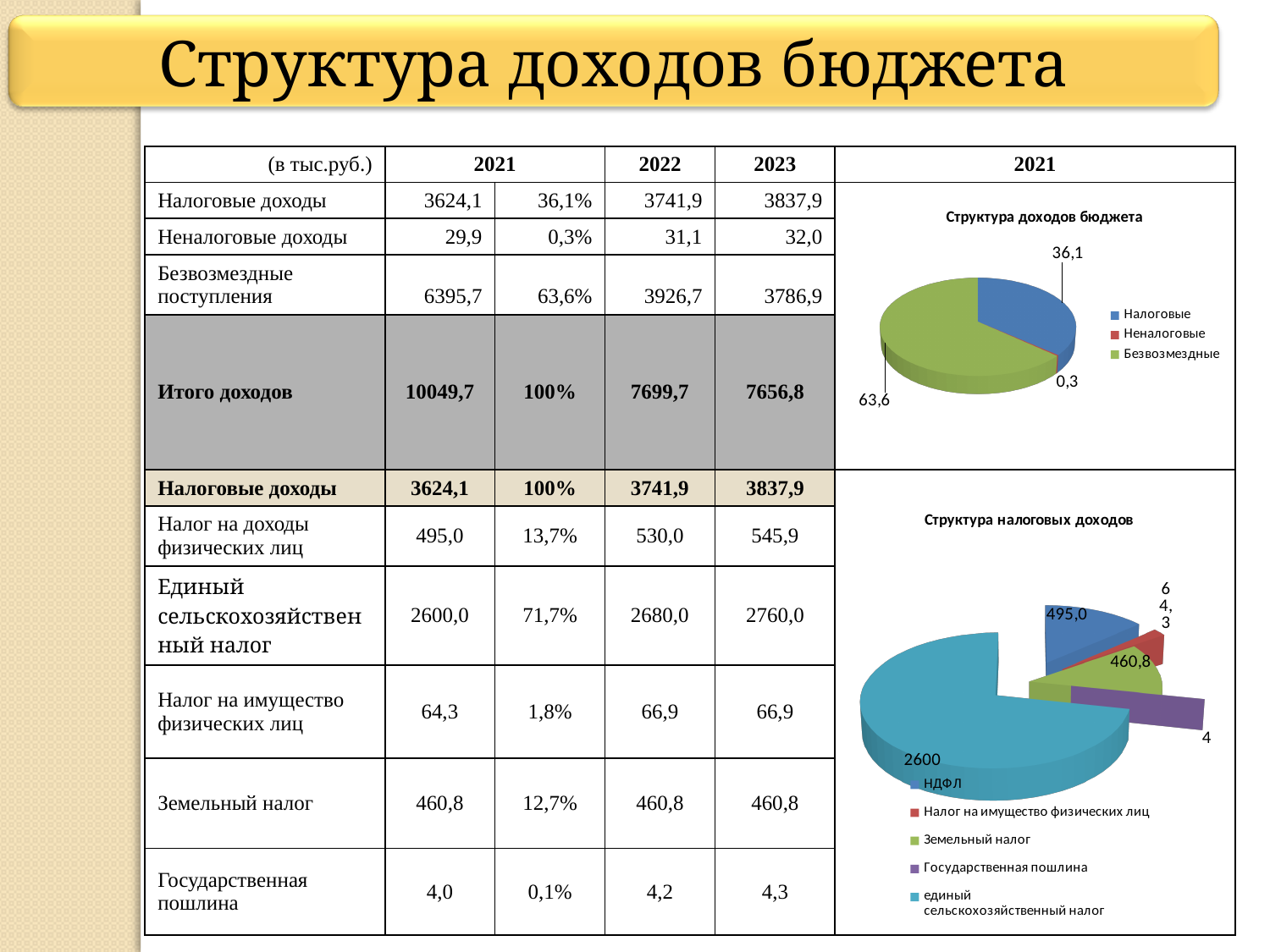
How many categories does the legend of the "Структура налоговых доходов" chart list? 5 In the "Структура налоговых доходов" chart, what is the value shown for Земельный налог? 460,8 In the "Структура налоговых доходов" chart, what is the value shown for НДФЛ? 495,0 What kind of chart is the "Структура доходов бюджета" chart? pie chart In the "Структура доходов бюджета" chart, what is the value shown for Налоговые? 36,1 What kind of chart is the "Структура налоговых доходов" chart? pie chart In the "Структура налоговых доходов" chart, which category has the largest slice? единый сельскохозяйственный налог In the "Структура доходов бюджета" chart, which category has the smallest slice? Неналоговые How many categories does the legend of the "Структура доходов бюджета" chart list? 3 In the "Структура доходов бюджета" chart, what is the value shown for Безвозмездные? 63,6 In the "Структура доходов бюджета" chart, what is the value shown for Неналоговые? 0,3 In the "Структура доходов бюджета" chart, which category has the largest slice? Безвозмездные